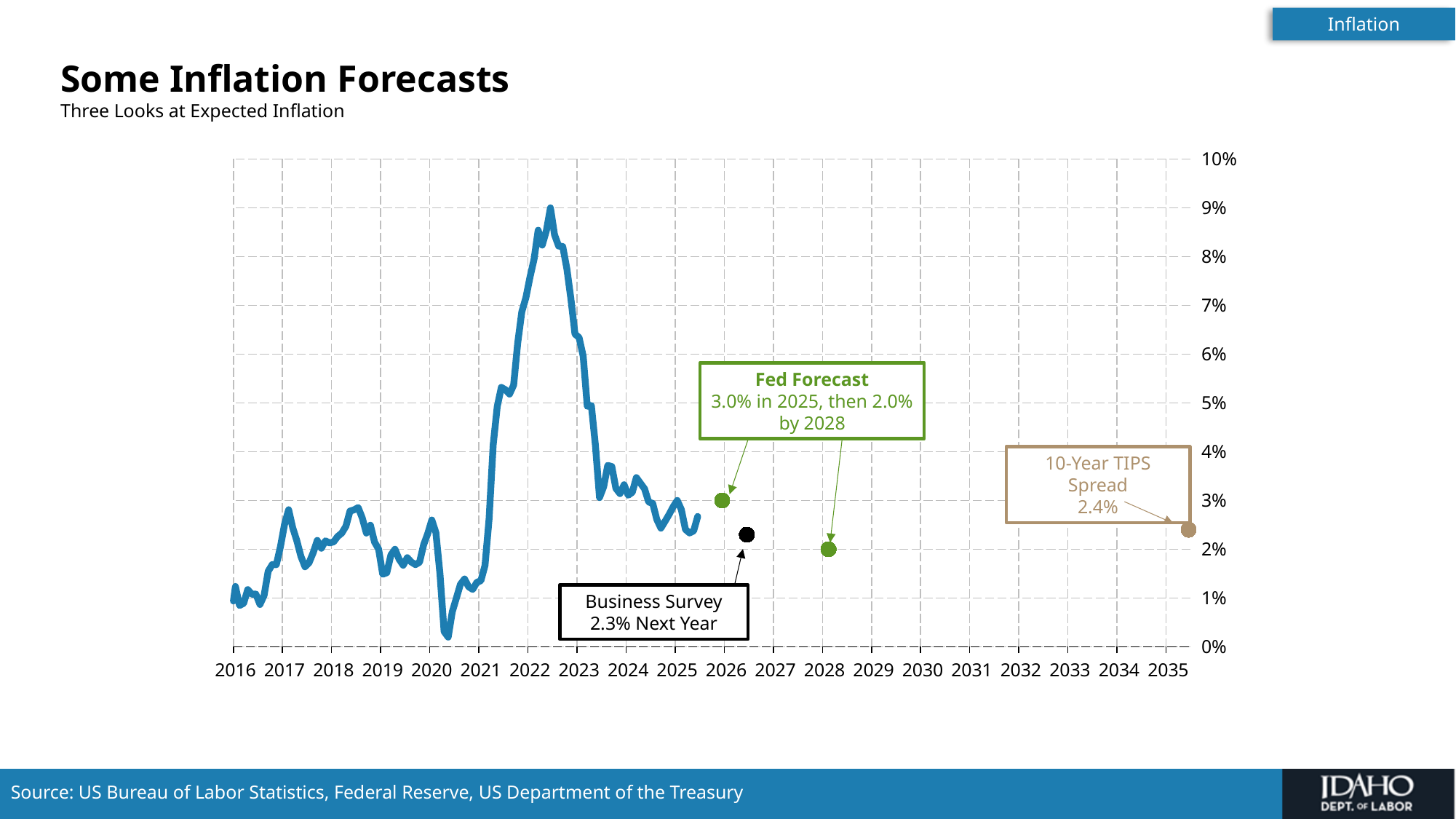
What is the title of the slide's chart? Some Inflation Forecasts By how many percentage points does the Fed Forecast fall from 2025 to 2028? 1.0 percentage points Is the lowest point of the inflation line in 2020 greater or less than 1%? less What is the Fed Forecast for inflation in 2025? 3.0% What kind of chart is shown on the slide? line chart What is the 10-Year TIPS Spread shown on the chart? 2.4% Is the peak of the inflation line in 2022 greater or less than 8%? greater Does the inflation line rise or fall between its 2022 peak and 2024? fall Which of the three forecasts shown has the highest value? Fed Forecast for 2025 (3.0%) Which is higher, the 10-Year TIPS Spread or the Business Survey forecast for next year? 10-Year TIPS Spread What inflation rate does the Business Survey expect next year? 2.3% What inflation rate does the Fed Forecast show by 2028? 2.0%